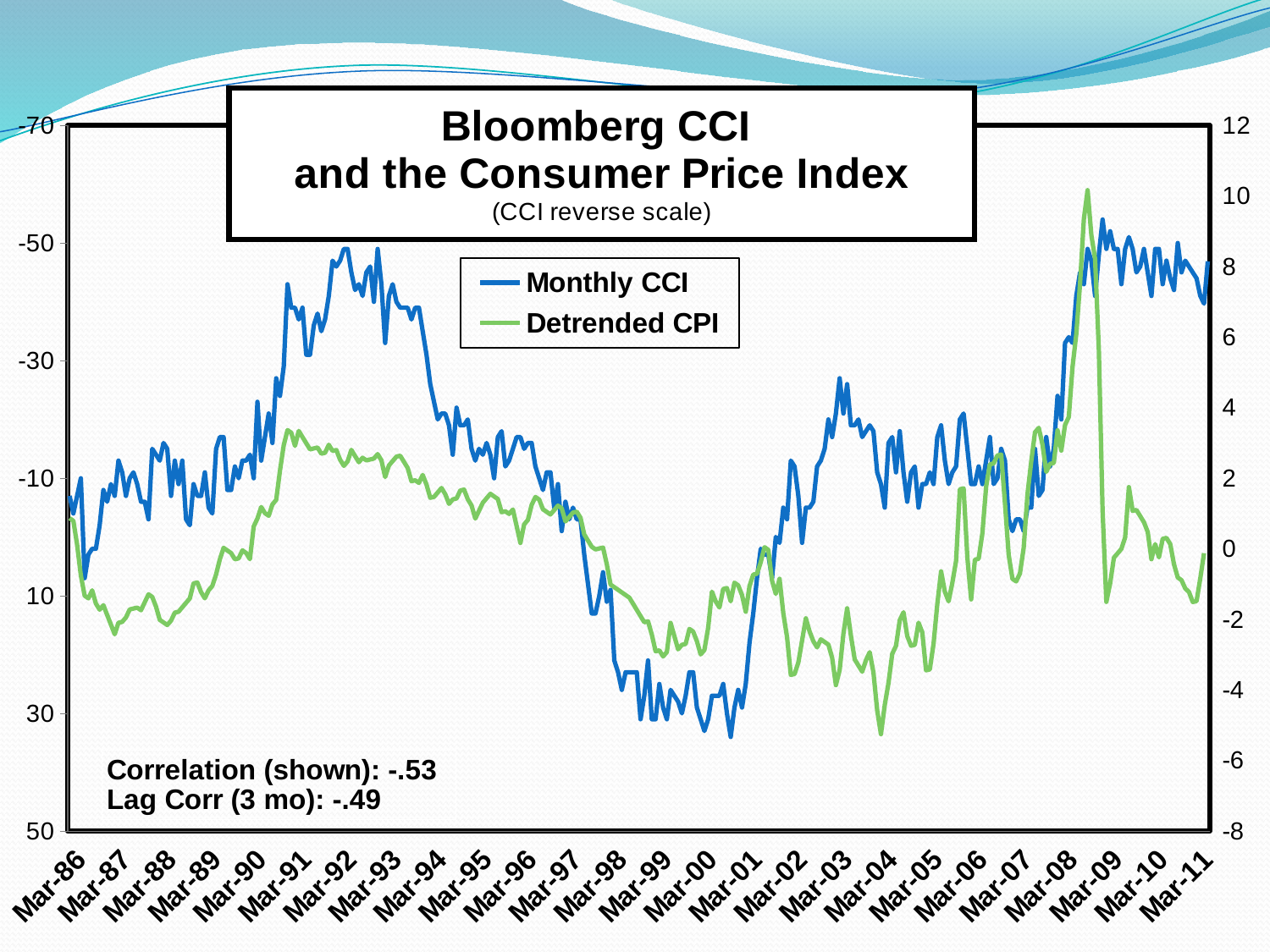
What is the title of the chart? Bloomberg CCI and the Consumer Price Index Which is larger, the Detrended CPI value at Mar-91 or at Mar-04? Mar-91 At which x-axis label does the Detrended CPI reach its lowest value? Mar-04 Is the Detrended CPI value at Mar-91 greater or less than 2? greater How many series does the legend list? 2 What correlation value is shown on the chart? -.53 How many date labels are shown along the x axis? 26 Is the Detrended CPI value at Mar-04 greater or less than 0? less Does the Detrended CPI rise or fall between Mar-97 and Mar-99? fall In which year does the Detrended CPI reach its highest value? 2008 Is the Monthly CCI value at Mar-99 greater or less than 10? greater What kind of chart is shown on the slide? line chart